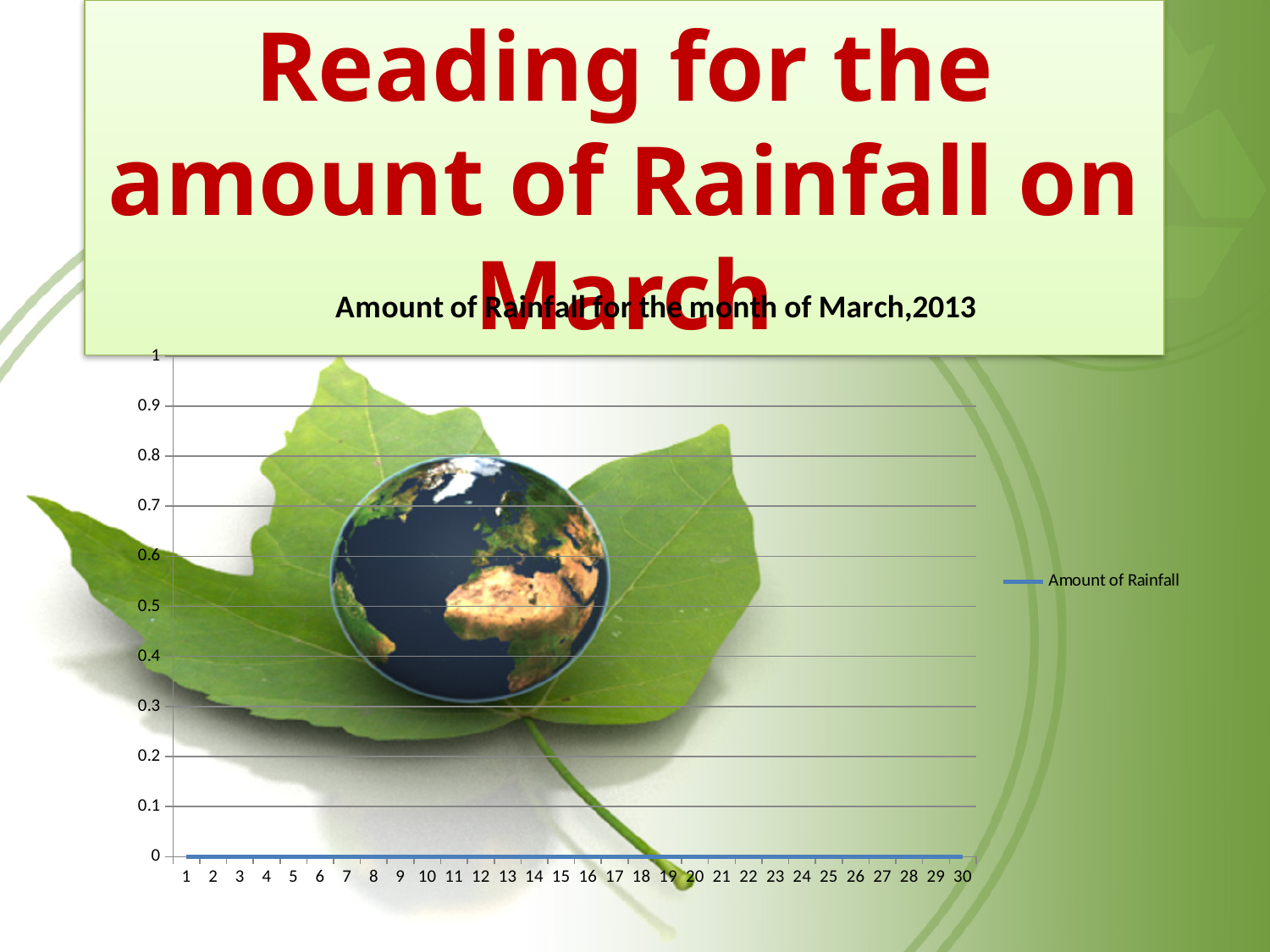
What is the difference between the values for day 5 and day 25? 0 What is the value of Amount of Rainfall on day 1? 0 What is the title of the chart? Amount of Rainfall for the month of March,2013 Is the value for day 10 greater or less than 0.5? less How many days (points) are plotted along the x axis? 30 What is the highest value shown on the vertical axis? 1 What is the name of the series shown in the legend? Amount of Rainfall What kind of chart is shown on the slide? line chart How many series does the chart legend list? 1 What is the value of Amount of Rainfall on day 30? 0 What is the value of Amount of Rainfall on day 15? 0 Do the values rise, fall, or stay flat from day 1 to day 30? stay flat